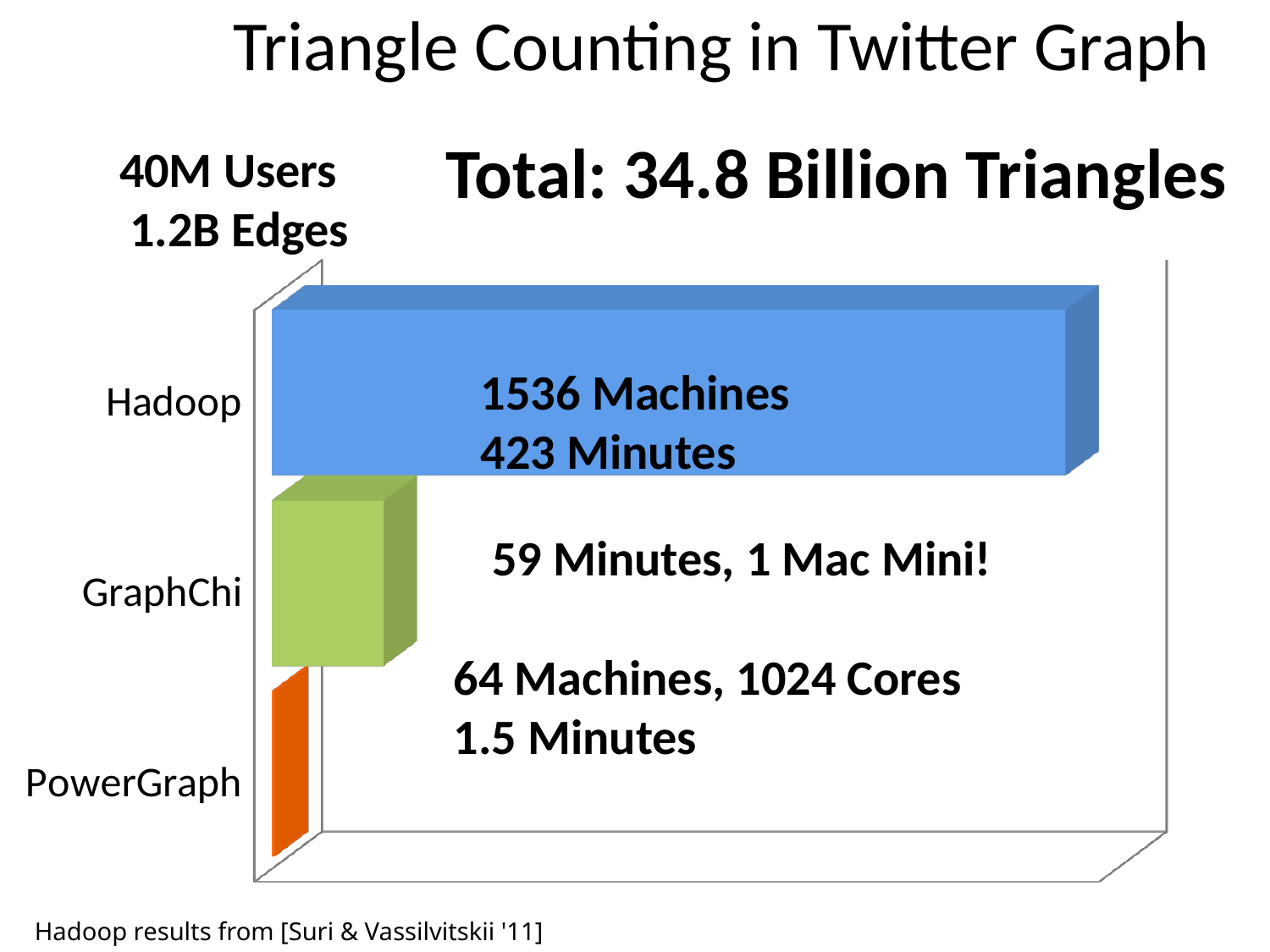
What is the difference in minutes between Hadoop and GraphChi? 364 Minutes What kind of chart is shown on the slide? Bar chart How many machines and cores did PowerGraph use according to the chart annotation? 64 Machines, 1024 Cores How many minutes did GraphChi take according to the chart annotation? 59 Minutes How many categories (systems) are plotted in the chart? 3 How many machines did Hadoop use according to the chart annotation? 1536 Machines How many minutes did Hadoop take according to the chart annotation? 423 Minutes Which system has the shortest bar in the chart? PowerGraph How many minutes did PowerGraph take according to the chart annotation? 1.5 Minutes What is the title of the slide containing the chart? Triangle Counting in Twitter Graph Which took longer, GraphChi or PowerGraph? GraphChi Which system has the longest bar in the chart? Hadoop